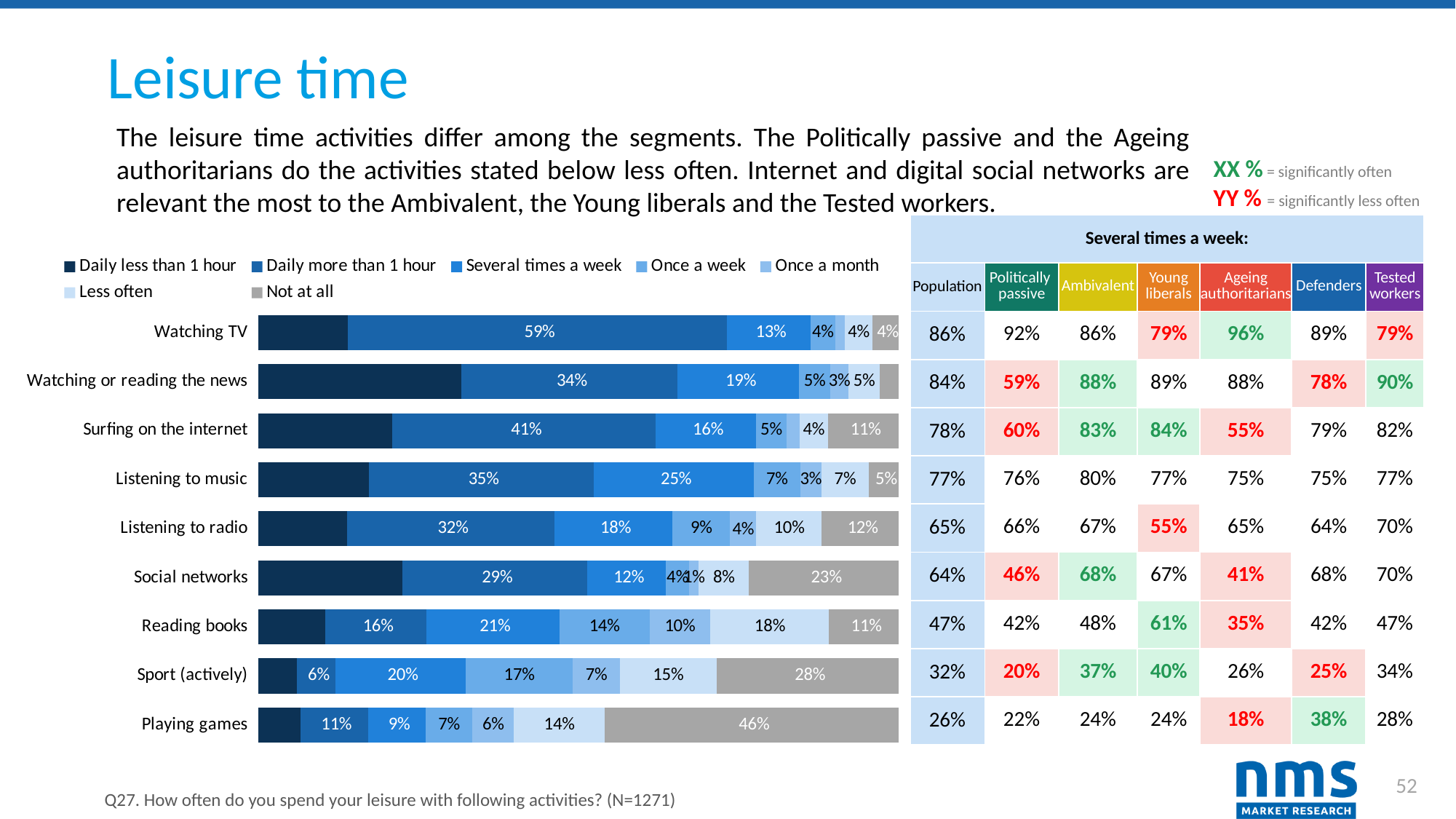
What is the difference between the 'Not at all' values for Playing games (46%) and Sport (actively) (28%)? 18 percentage points What is the 'Not at all' value for Social networks? 23% What is the 'Several times a week' value for Listening to music? 25% How many leisure activities (categories) are plotted in the bar chart? 9 Which activity has the highest 'Not at all' share? Playing games What kind of chart is shown on the slide? Bar chart Which is larger: the 'Daily more than 1 hour' value for Watching TV or for Surfing on the internet? Watching TV How many series does the chart legend list? 7 What is the first entry in the chart legend? Daily less than 1 hour What is the 'Daily more than 1 hour' value for Watching TV? 59% Which is larger: the 'Not at all' value for Sport (actively) or for Playing games? Playing games What is the 'Not at all' value for Playing games? 46%